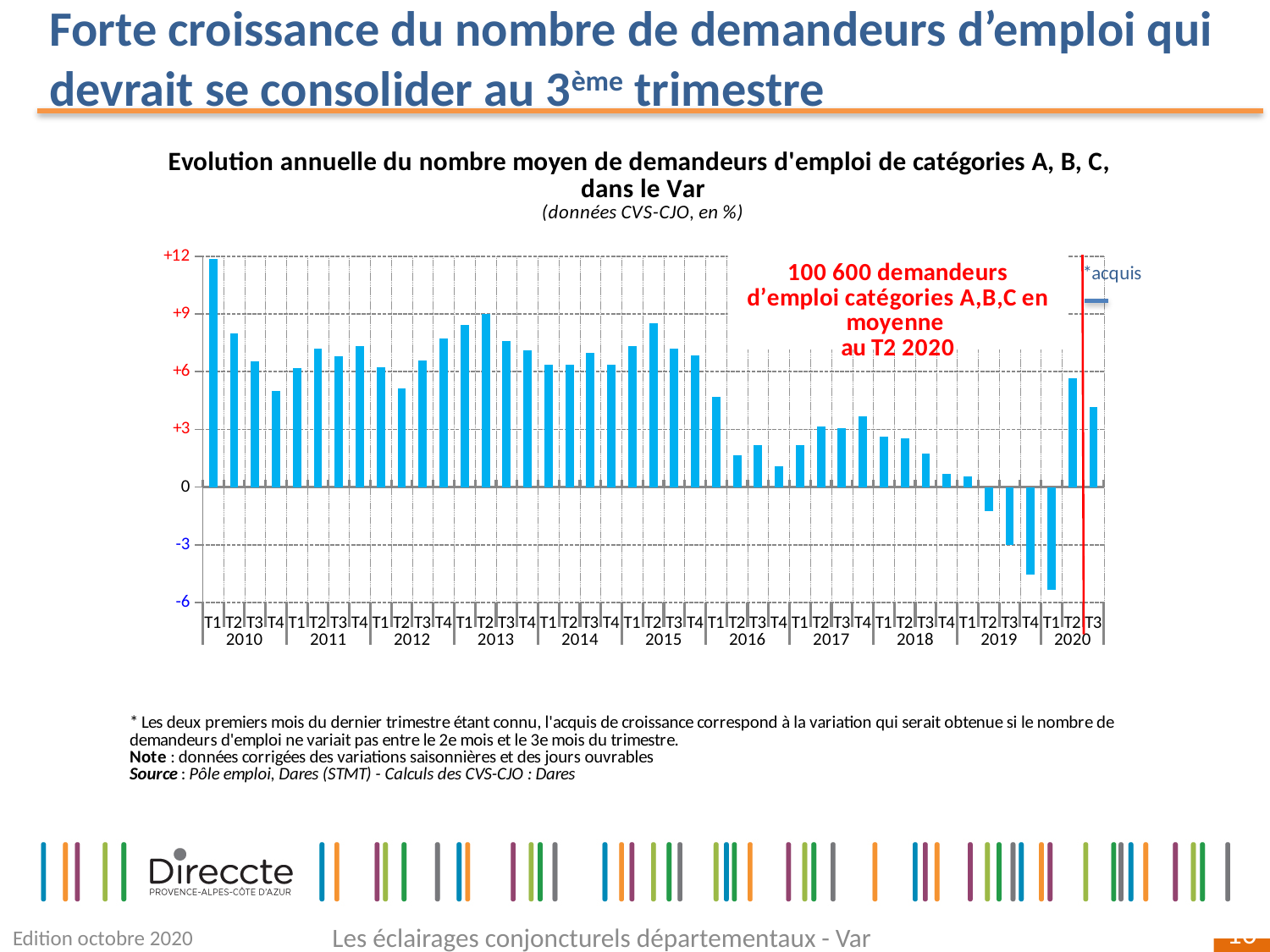
How many years are labelled on the x axis? 11 Is the value for T1 2010 greater or less than +9? greater Which is larger, the value for T2 2020 or the value for T3 2020? T2 2020 According to the annotation on the chart, how many job seekers in categories A, B, C were there on average in T2 2020? 100 600 Is the value for T1 2016 greater or less than +3? greater Is the value for T1 2020 greater or less than -3? less What kind of chart is shown on the slide? bar chart Which quarter has the highest value on the chart? T1 2010 Which quarter has the lowest value on the chart? T1 2020 Do the values rise or fall from T1 2019 to T4 2019? fall